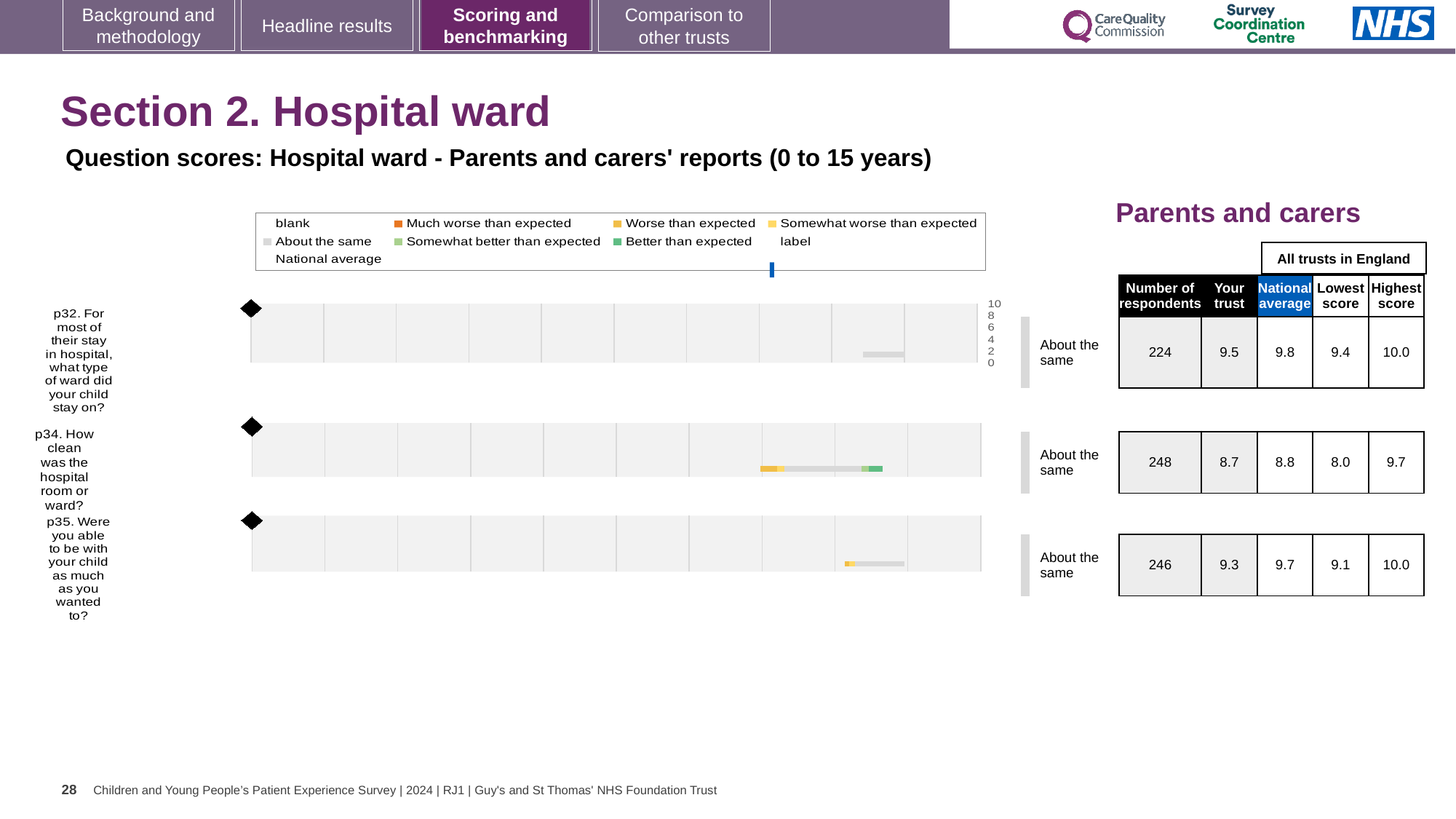
Which question has the highest 'Your trust' score? p32 Which question has the lowest 'Your trust' score? p34 How many entries does the chart legend list? 9 How many questions (p32, p34, p35) are plotted on the slide? 3 What kind of chart is used to show the question scores on this slide? bar chart Which has the larger 'Your trust' score, p32 or p35? p32 What is the national average score for p32 (what type of ward did your child stay on)? 9.8 What is the difference between the national average and the 'Your trust' score for p35? 0.4 What is the lowest score across all trusts in England for p34? 8.0 How many respondents answered p35 (Were you able to be with your child as much as you wanted to)? 246 What benchmark category is shown for all three questions on the slide? About the same What is the 'Your trust' score for p34 (How clean was the hospital room or ward)? 8.7